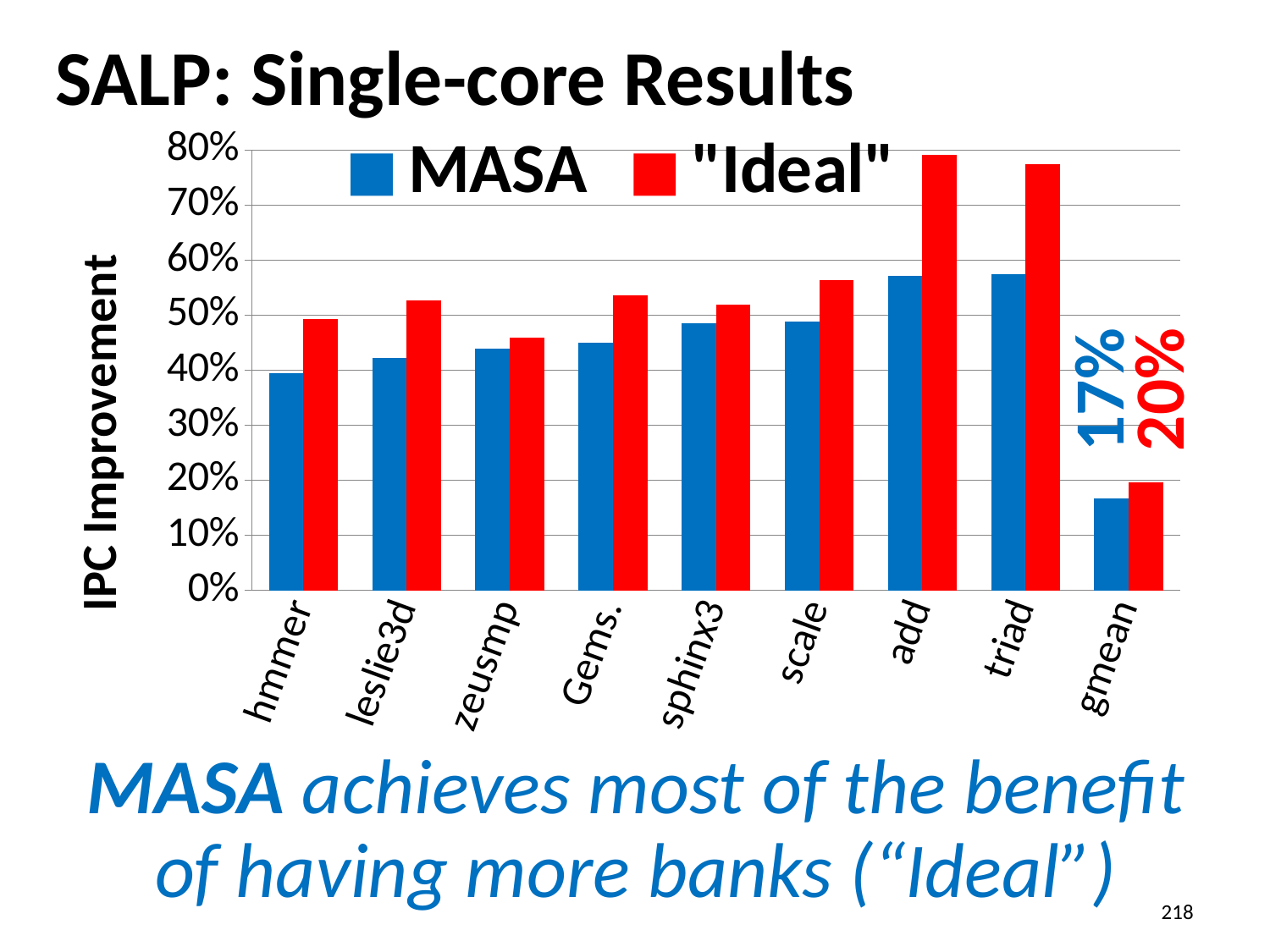
Which category has the lowest MASA bar? gmean Is the "Ideal" value for add greater or less than 70%? greater What is the MASA value for gmean? 17% Which category has the highest "Ideal" bar? add Is the MASA value for triad greater or less than 50%? greater What is the "Ideal" value for gmean? 20% How many categories are shown on the x axis? 9 What is the difference between the "Ideal" and MASA values for gmean? 3% How many series does the legend list? 2 What is the title of the y axis? IPC Improvement For hmmer, which is larger: the MASA value or the "Ideal" value? "Ideal" Is the "Ideal" value for zeusmp greater or less than 50%? less